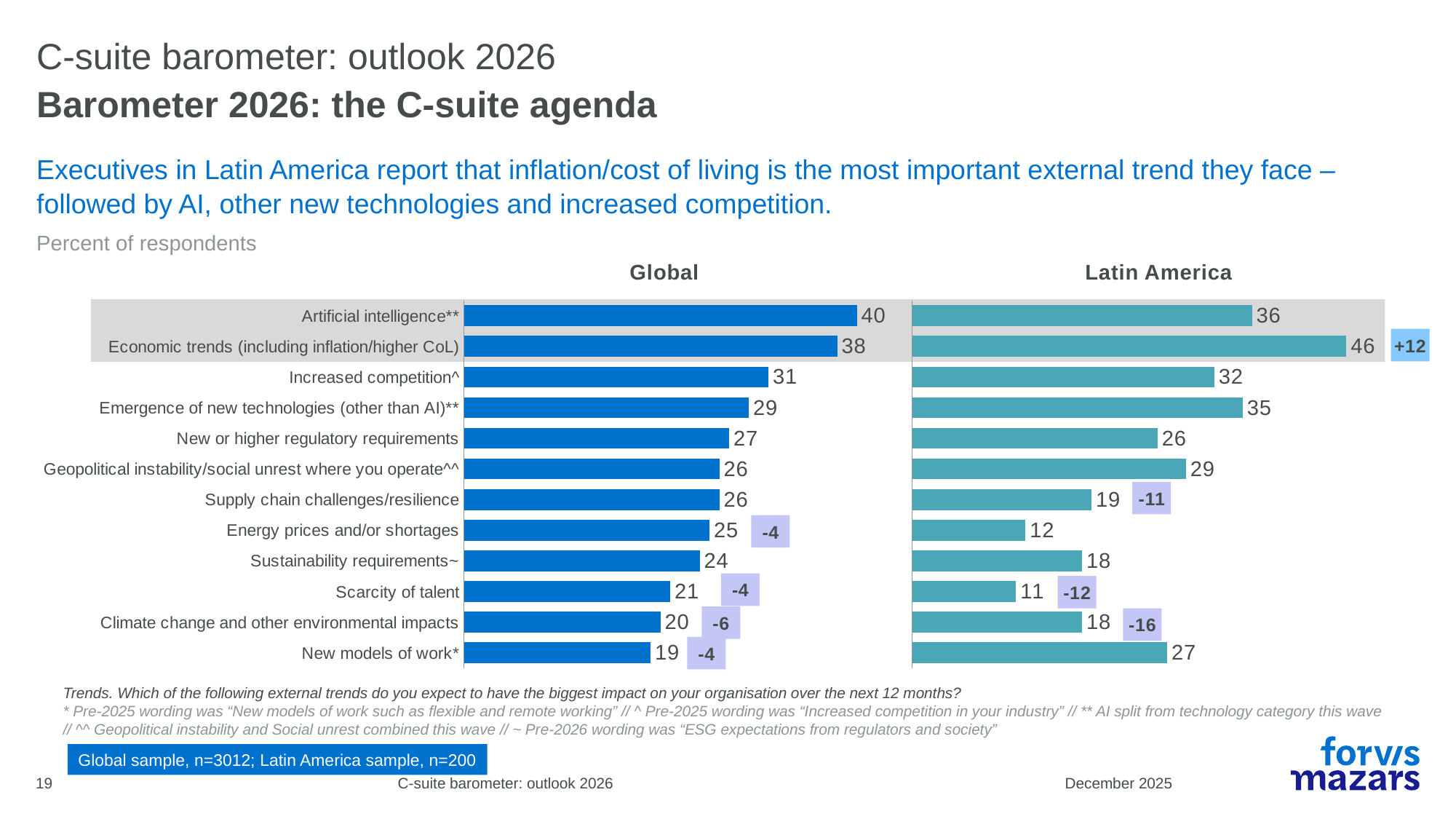
In the Global chart, which category has the lowest value? New models of work* Which is larger for New models of work: the Global value or the Latin America value? Latin America In the Latin America chart, what is the value for Energy prices and/or shortages? 12 What is the difference between the Latin America and Global values for Economic trends (including inflation/higher CoL)? 8 What kind of chart is used to show the Global and Latin America values? Bar chart In the Latin America chart, what is the difference between Emergence of new technologies (other than AI) and Supply chain challenges/resilience? 16 What is the sample size for Latin America shown on the slide? n=200 How many categories are shown in the Global chart? 12 In the Latin America chart, which category has the lowest value? Scarcity of talent In the Global chart, what percent of respondents selected Artificial intelligence? 40 In the Global chart, which category has the highest value? Artificial intelligence** In the Latin America chart, what percent of respondents selected Economic trends (including inflation/higher CoL)? 46